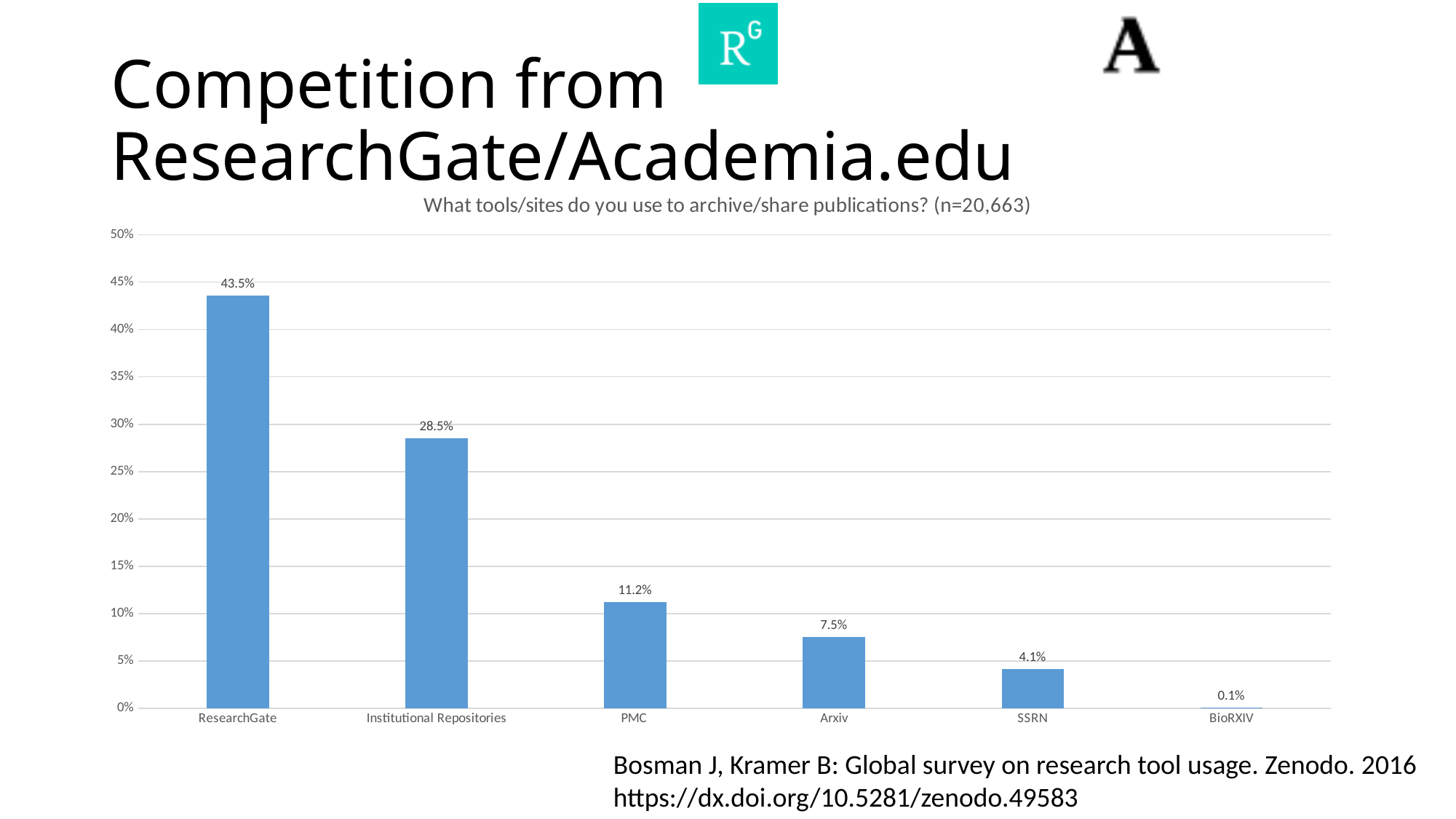
What is the difference between the values for PMC and Arxiv? 3.7% Which tool/site has the lowest value in the chart? BioRXIV What is the title of the chart? What tools/sites do you use to archive/share publications? (n=20,663) Which has a larger value, Arxiv or SSRN? Arxiv Which tool/site has the highest value in the chart? ResearchGate What kind of chart is shown on the slide? Bar chart What is the value shown for PMC? 11.2% What is the value shown for Institutional Repositories? 28.5% What is the difference between the values for ResearchGate and Institutional Repositories? 15.0% What percentage of respondents use ResearchGate to archive/share publications? 43.5% What is the value shown for SSRN? 4.1% How many tools/sites are shown on the x axis of the chart? 6